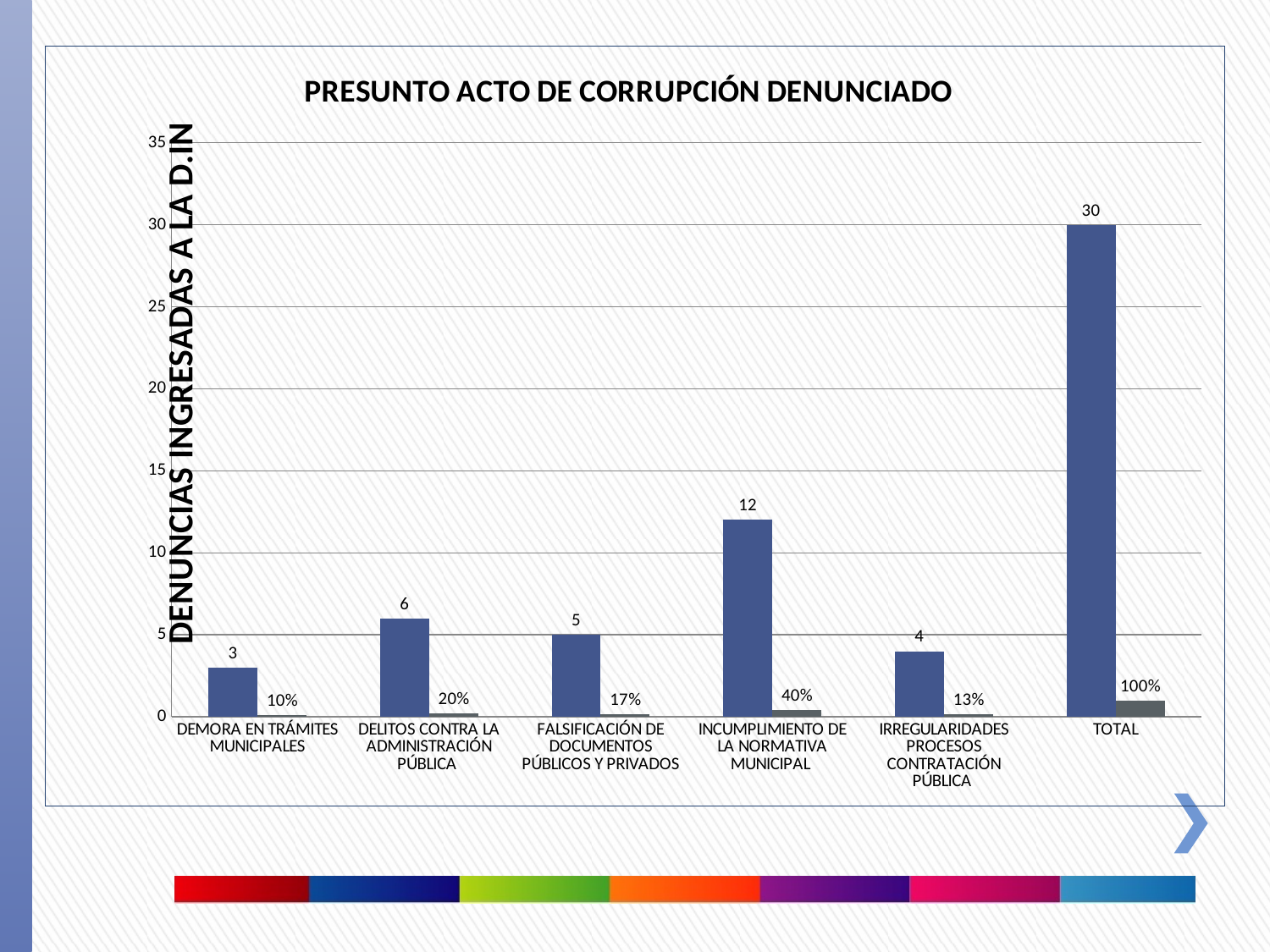
What percentage is shown for DELITOS CONTRA LA ADMINISTRACIÓN PÚBLICA? 20% How many categories are shown on the x axis of the chart? 6 Excluding TOTAL, which category has the highest number of complaints? INCUMPLIMIENTO DE LA NORMATIVA MUNICIPAL What is the label of the vertical axis? DENUNCIAS INGRESADAS A LA D.IN Which has more complaints: DELITOS CONTRA LA ADMINISTRACIÓN PÚBLICA or IRREGULARIDADES PROCESOS CONTRATACIÓN PÚBLICA? DELITOS CONTRA LA ADMINISTRACIÓN PÚBLICA What is the number of complaints for INCUMPLIMIENTO DE LA NORMATIVA MUNICIPAL? 12 What percentage is shown for IRREGULARIDADES PROCESOS CONTRATACIÓN PÚBLICA? 13% What is the number of complaints for DEMORA EN TRÁMITES MUNICIPALES? 3 Which category has the lowest number of complaints? DEMORA EN TRÁMITES MUNICIPALES What is the difference between the number of complaints for INCUMPLIMIENTO DE LA NORMATIVA MUNICIPAL and FALSIFICACIÓN DE DOCUMENTOS PÚBLICOS Y PRIVADOS? 7 What type of chart is shown on the slide? bar chart What is the title of the chart? PRESUNTO ACTO DE CORRUPCIÓN DENUNCIADO